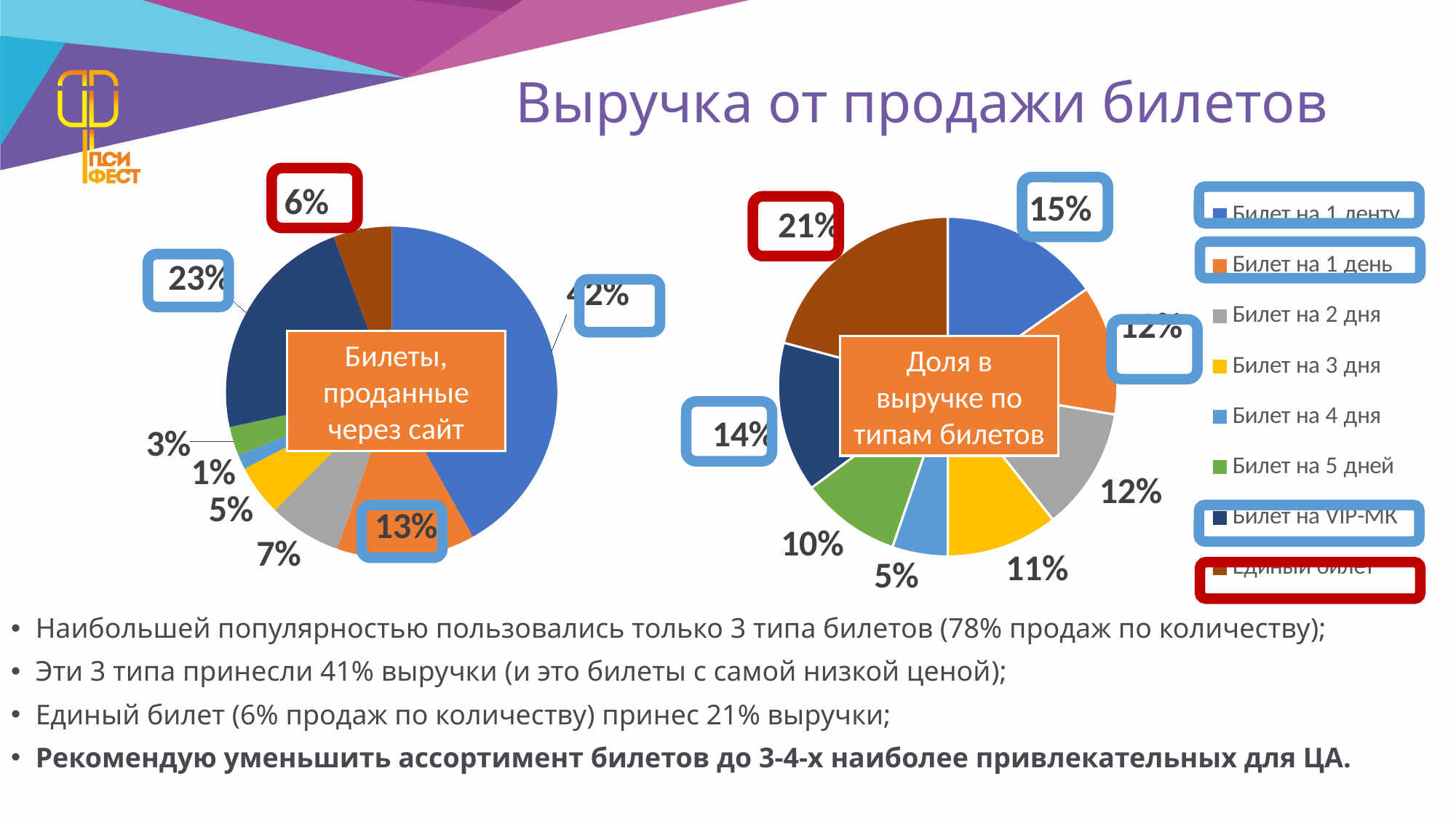
In the "Билеты, проданные через сайт" chart, which ticket type has the smallest share? Билет на 4 дня In the "Билеты, проданные через сайт" chart, what is the difference between the shares of "Билет на VIP-МК" and "Билет на 1 день"? 10% In the "Билеты, проданные через сайт" chart, what share does "Единый билет" have? 6% In the "Доля в выручке по типам билетов" chart, which ticket type has the largest share? Единый билет What type of chart is used for "Билеты, проданные через сайт"? pie chart What is the title of the slide? Выручка от продажи билетов In the "Доля в выручке по типам билетов" chart, what share does "Билет на 1 ленту" have? 15% In the "Доля в выручке по типам билетов" chart, what share does "Единый билет" have? 21% In the "Билеты, проданные через сайт" chart, what share does "Билет на VIP-МК" have? 23% How many ticket types does the legend list? 8 In the "Доля в выручке по типам билетов" chart, which ticket type has the smallest share? Билет на 4 дня In the "Доля в выручке по типам билетов" chart, which is larger: the share of "Билет на VIP-МК" or "Билет на 5 дней"? Билет на VIP-МК